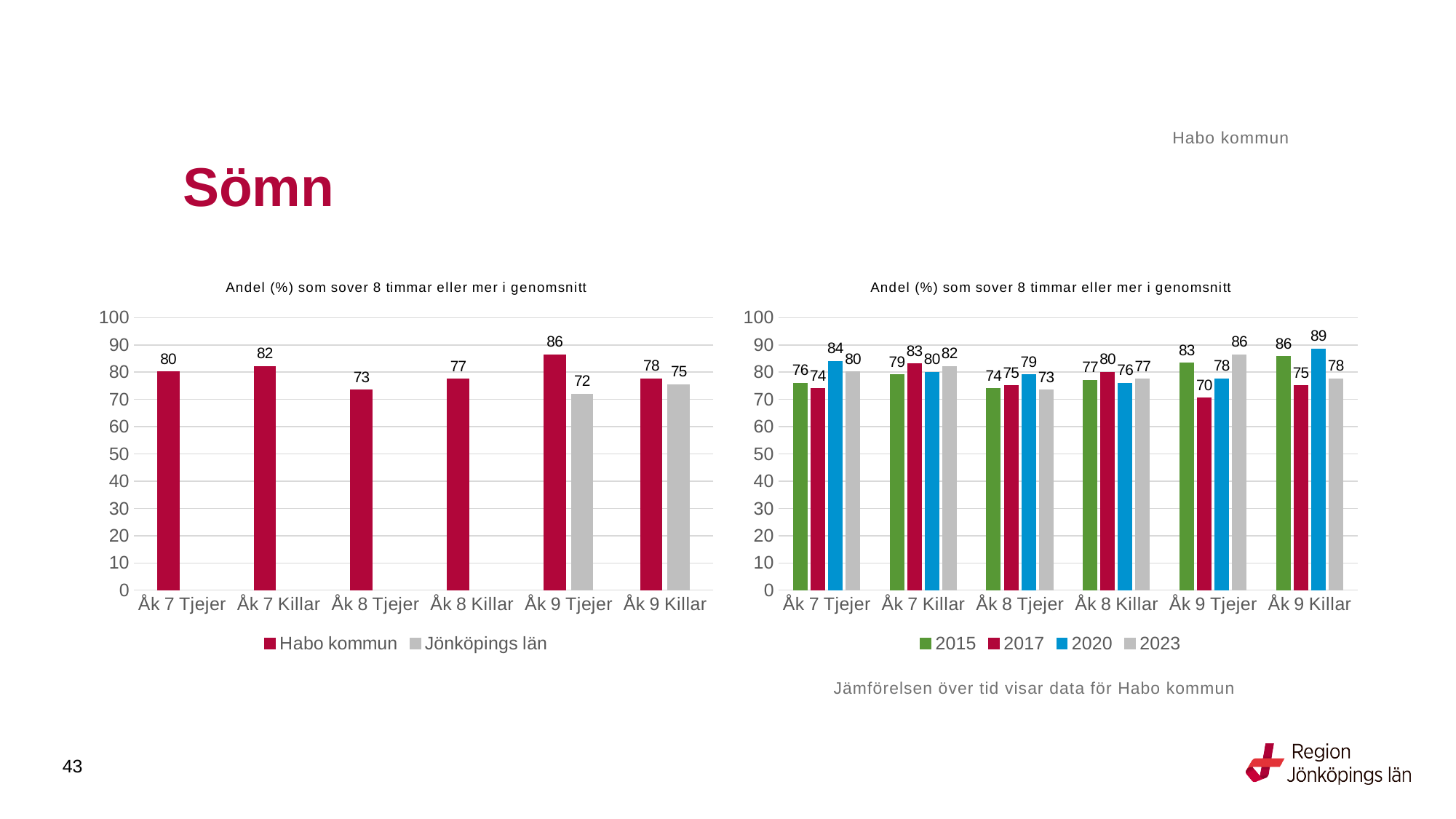
How many categories are shown on the x axis of the right chart? 6 In the right chart, what is the value for 2017 for Åk 9 Tjejer? 70 In the right chart, which year has the lowest value for Åk 9 Tjejer? 2017 What kind of chart is the left chart? bar chart In the right chart, how many series does the legend list? 4 In the left chart, what is the value for Jönköpings län for Åk 9 Tjejer? 72 In the left chart, what is the value for Habo kommun for Åk 8 Tjejer? 73 In the left chart, which category has the highest value for Habo kommun? Åk 9 Tjejer In the left chart, what is the difference between Habo kommun and Jönköpings län for Åk 9 Tjejer? 14 In the right chart, is the value for 2015 for Åk 7 Tjejer larger or smaller than the value for 2020 for Åk 7 Tjejer? smaller In the right chart, what is the value for 2020 for Åk 9 Killar? 89 In the left chart, how many series does the legend list? 2